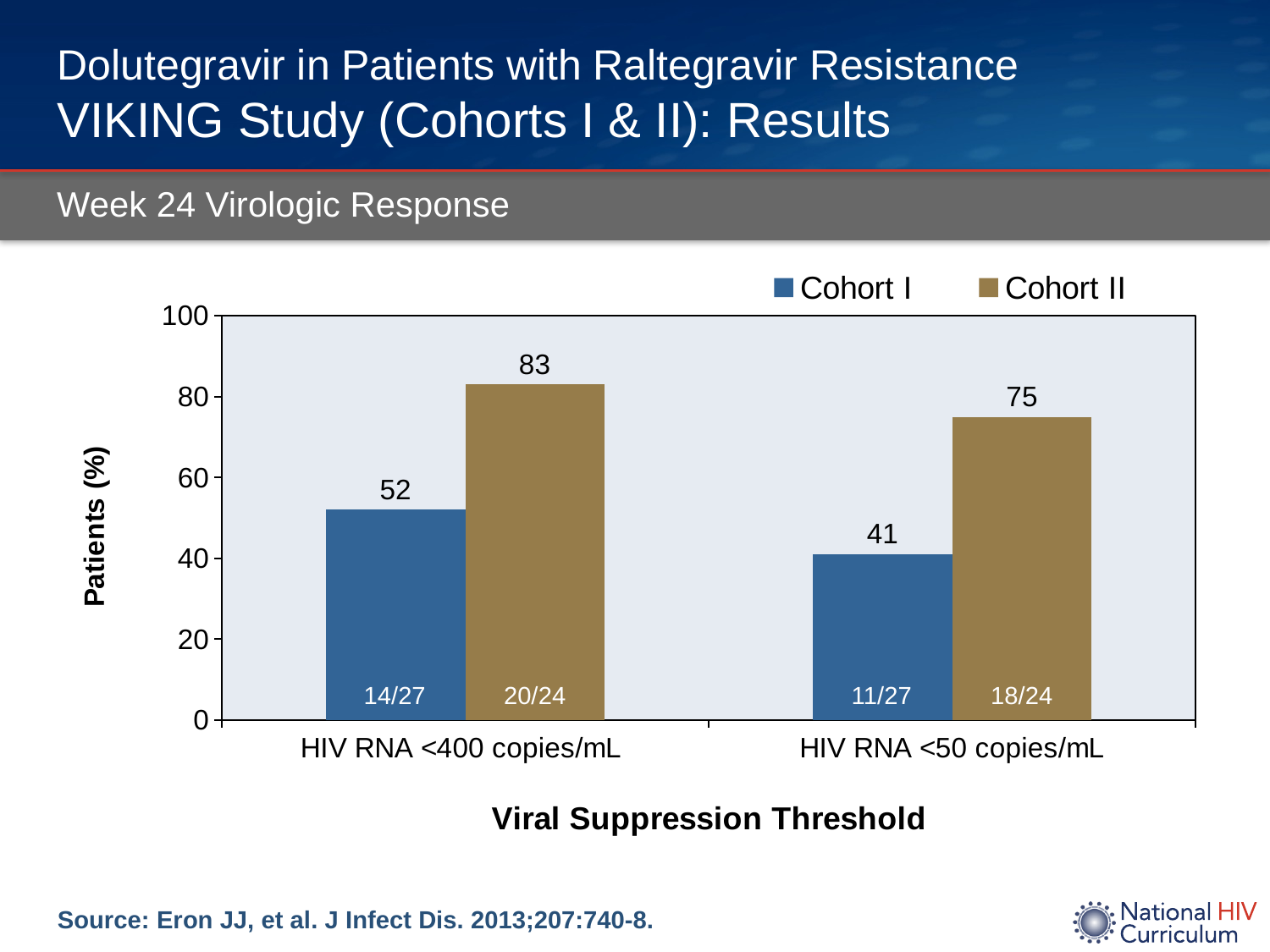
What is the label of the y axis? Patients (%) What kind of chart is shown on the slide? Bar chart What is the value for Cohort I at HIV RNA <400 copies/mL? 52 What is the value for Cohort I at HIV RNA <50 copies/mL? 41 What is the value for Cohort II at HIV RNA <50 copies/mL? 75 Which is larger at HIV RNA <50 copies/mL, Cohort I or Cohort II? Cohort II What is the value for Cohort II at HIV RNA <400 copies/mL? 83 What is the difference between Cohort II and Cohort I at HIV RNA <400 copies/mL? 31 What is the difference between Cohort II and Cohort I at HIV RNA <50 copies/mL? 34 How many series does the legend list? 2 Which bar has the highest value on the chart? Cohort II at HIV RNA <400 copies/mL Which bar has the lowest value on the chart? Cohort I at HIV RNA <50 copies/mL